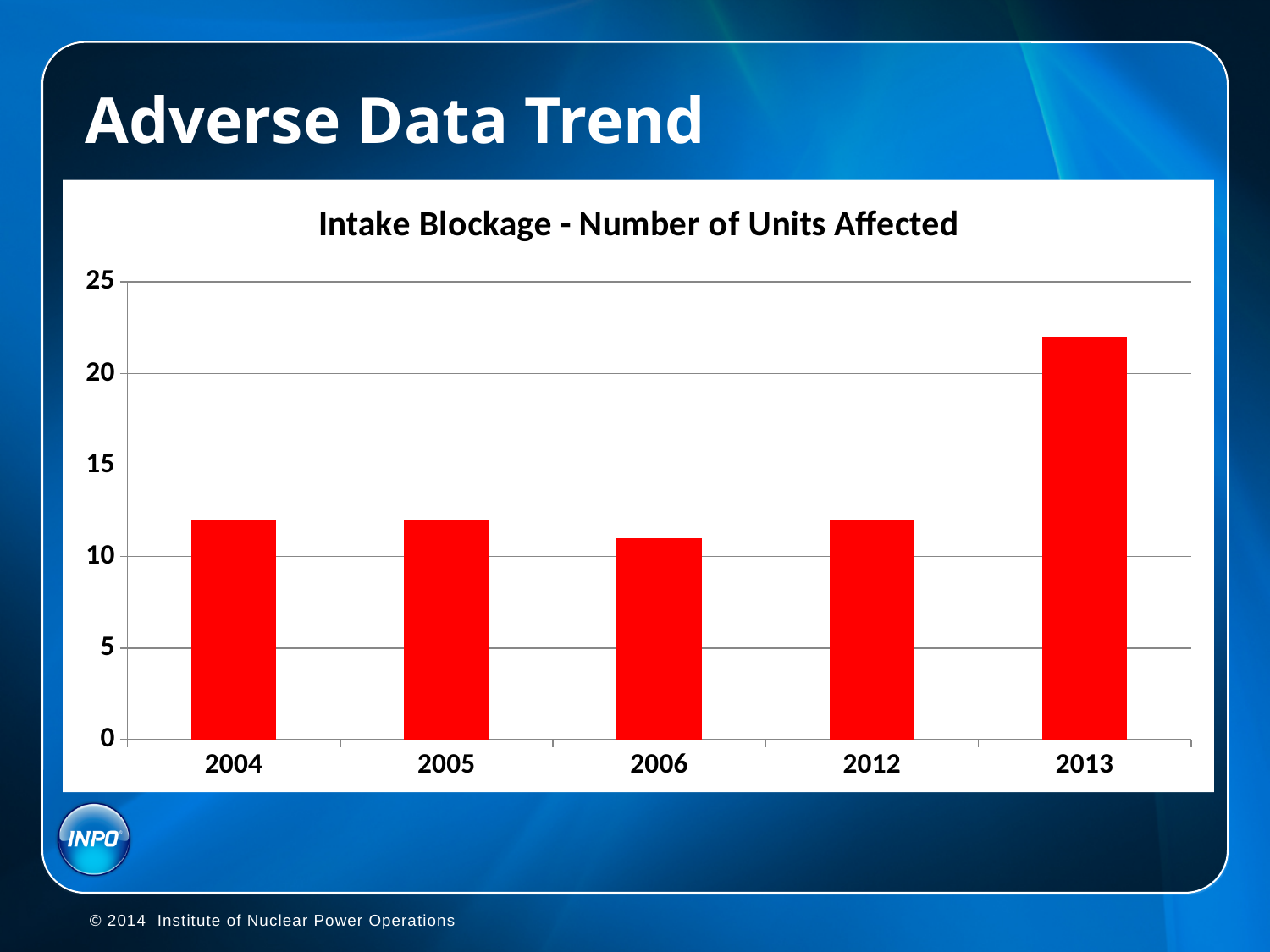
Is the value for 2012 greater or less than 10? greater Is the value for 2004 greater or less than 15? less Which year has the lowest number of units affected? 2006 How many years are shown on the x axis of the chart? 5 What is the title of the chart? Intake Blockage - Number of Units Affected Is the value for 2006 greater or less than 15? less What colour are the bars in the chart? red Which is larger, the value for 2004 or the value for 2006? 2004 What kind of chart is shown on the slide? bar chart Which year has the highest number of units affected? 2013 Which is larger, the value for 2013 or the value for 2005? 2013